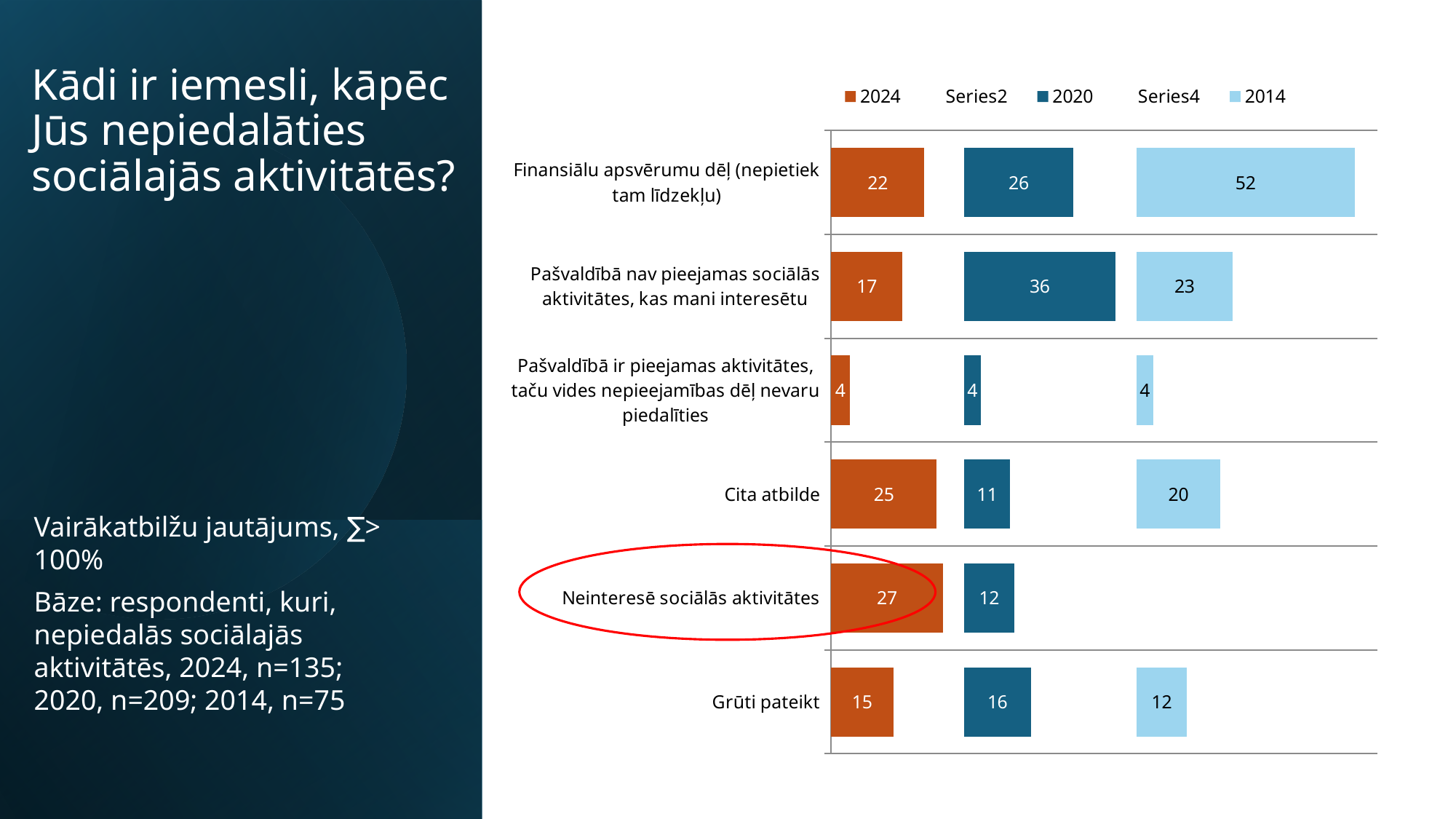
What is the 2024 value for "Neinteresē sociālās aktivitātes"? 27 What is the 2024 value for "Grūti pateikt"? 15 How many categories are shown on the chart? 6 Which category has the highest 2024 value? Neinteresē sociālās aktivitātes For "Cita atbilde", which is larger: the 2024 value or the 2020 value? 2024 What is the 2014 value for "Finansiālu apsvērumu dēļ (nepietiek tam līdzekļu)"? 52 Which category on the chart is circled in red? Neinteresē sociālās aktivitātes How many entries does the chart legend list? 5 What is the difference between the 2014 and 2024 values for "Finansiālu apsvērumu dēļ (nepietiek tam līdzekļu)"? 30 Which category has the lowest 2020 value? Pašvaldībā ir pieejamas aktivitātes, taču vides nepieejamības dēļ nevaru piedalīties What type of chart is shown on the slide? Bar chart What is the 2020 value for "Pašvaldībā nav pieejamas sociālās aktivitātes, kas mani interesētu"? 36